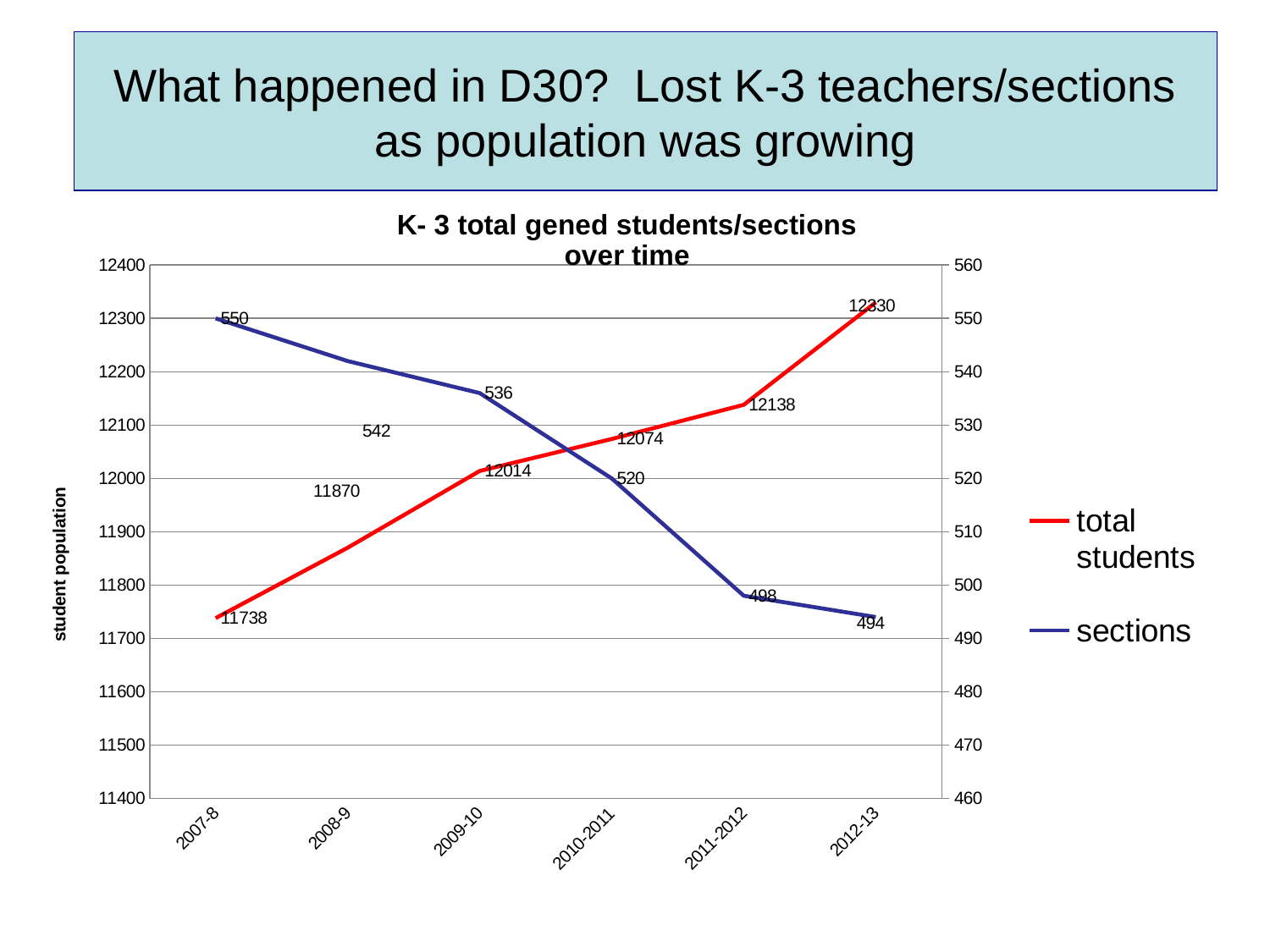
How many series does the legend list? 2 In which year is the total students value highest? 2012-13 What is the sections value for 2010-2011? 520 How many years are plotted on the x axis? 6 What is the difference in total students between 2012-13 and 2007-8? 592 What type of chart is shown on the slide? line chart In which year is the sections value lowest? 2012-13 Does the sections line rise or fall from 2007-8 to 2012-13? fall What is the difference in sections between 2007-8 and 2011-2012? 52 What is the total students value for 2007-8? 11738 What is the sections value for 2008-9? 542 What is the total students value for 2012-13? 12330